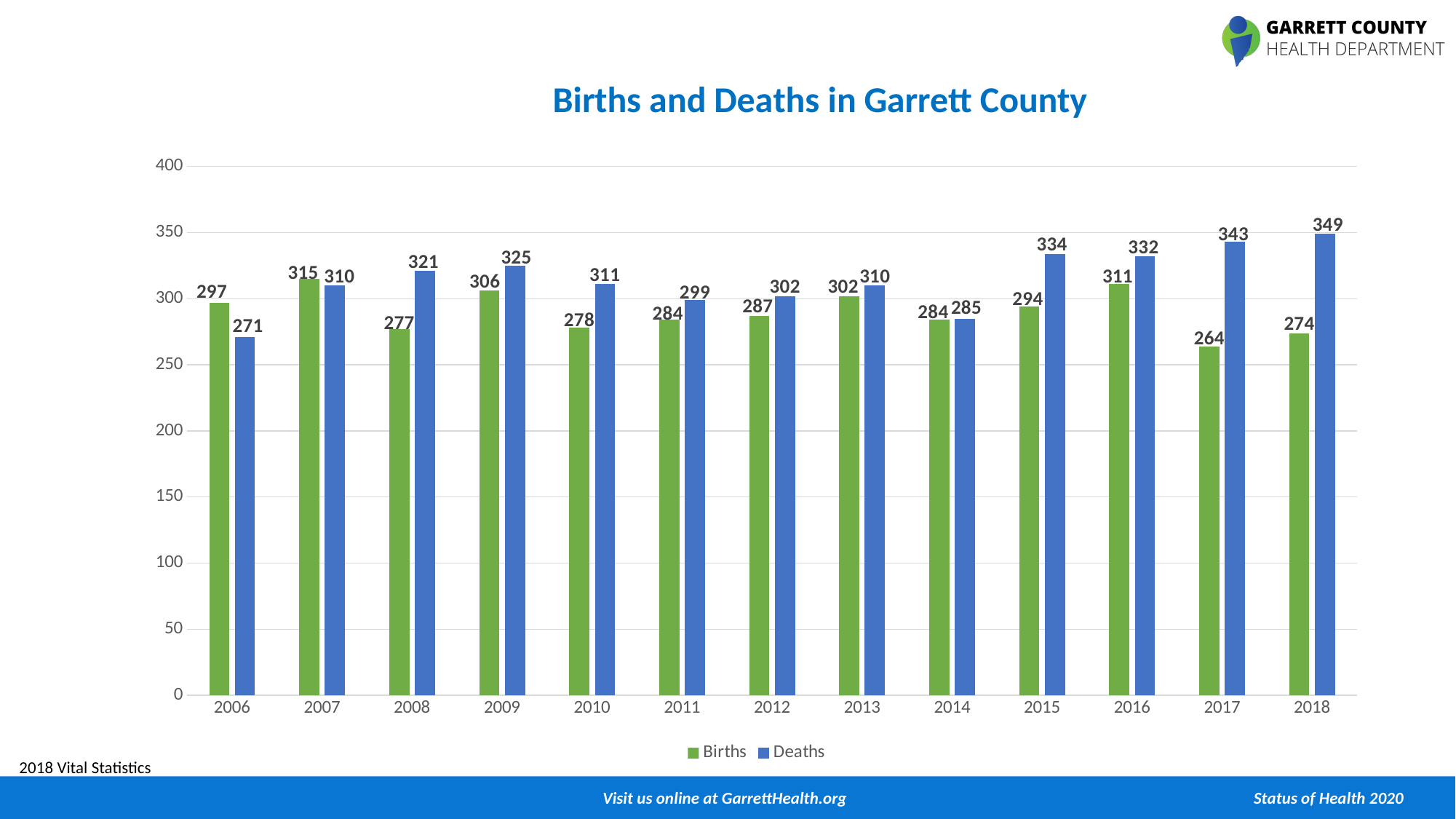
How many years are shown on the x axis? 13 What is the number of births in 2007? 315 Which year has the lowest number of births? 2017 Is the number of deaths in 2015 greater or less than 300? greater Which year has the highest number of deaths? 2018 Which is larger in 2006, births or deaths? Births What kind of chart is shown? Bar chart What is the number of deaths in 2006? 271 What is the number of deaths in 2018? 349 What is the difference between deaths and births in 2017? 79 How many series does the legend list? 2 What is the title of the chart? Births and Deaths in Garrett County